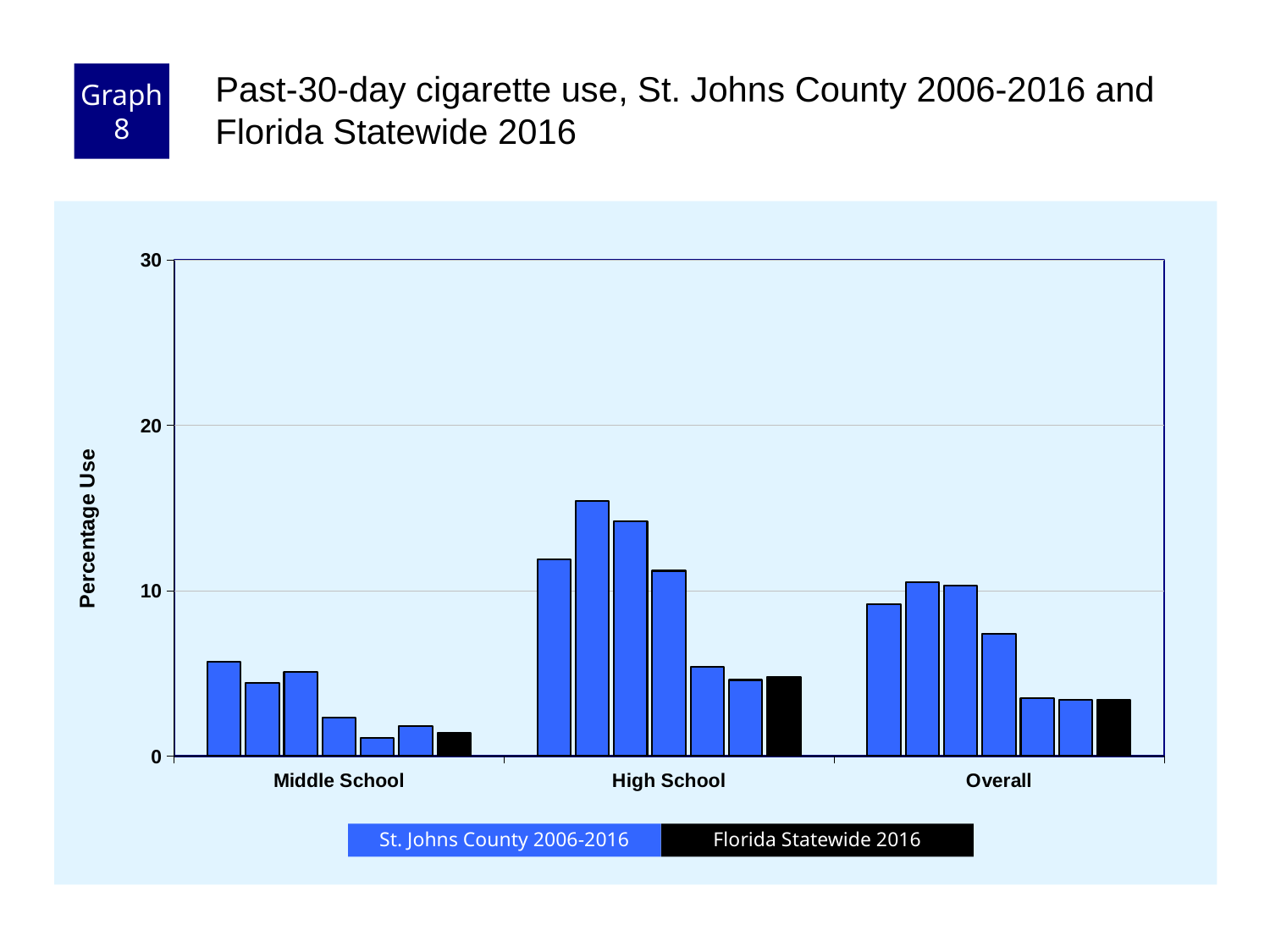
How many bars are plotted in the High School group? 7 How many category groups are shown on the x axis? 3 Is the tallest bar in the Middle School group greater or less than 10? less Is the tallest bar in the High School group greater or less than 10? greater Which category group contains the tallest bar on the chart? High School What is the label on the y axis? Percentage Use Which category group has the lowest bars overall? Middle School Is the Florida Statewide 2016 bar for High School greater or less than 10? less Is the Florida Statewide 2016 bar larger for High School or for Middle School? High School How many series does the legend list? 2 What kind of chart is shown on the slide? bar chart